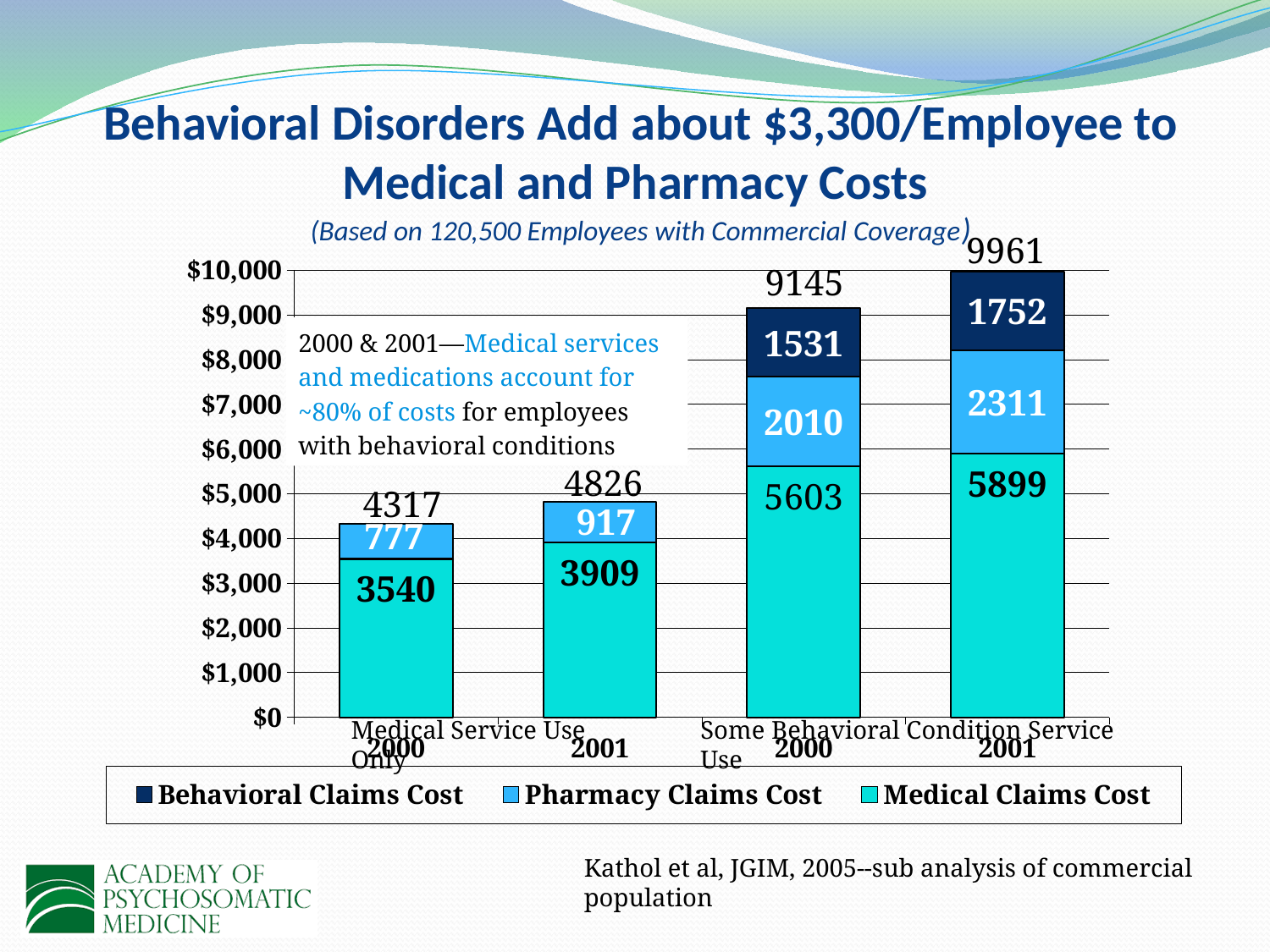
Is the Pharmacy Claims Cost larger for the Some Behavioral Condition Service Use group in 2000 or in 2001? 2001 What is the difference between the Medical Claims Cost for the Some Behavioral Condition Service Use group in 2001 and in 2000? 296 What is the Pharmacy Claims Cost for the Medical Service Use Only group in 2001? 917 Which bar has the lowest total cost? Medical Service Use Only, 2000 Which legend entry is shown in the darkest blue colour? Behavioral Claims Cost What kind of chart is shown on the slide? stacked bar chart What is the Behavioral Claims Cost for the Some Behavioral Condition Service Use group in 2001? 1752 What is the total labeled above the 2000 bar for the Some Behavioral Condition Service Use group? 9145 How many series does the legend list? 3 Which bar has the highest total cost? Some Behavioral Condition Service Use, 2001 What is the Medical Claims Cost for the Medical Service Use Only group in 2000? 3540 How many bars are plotted in the chart? 4